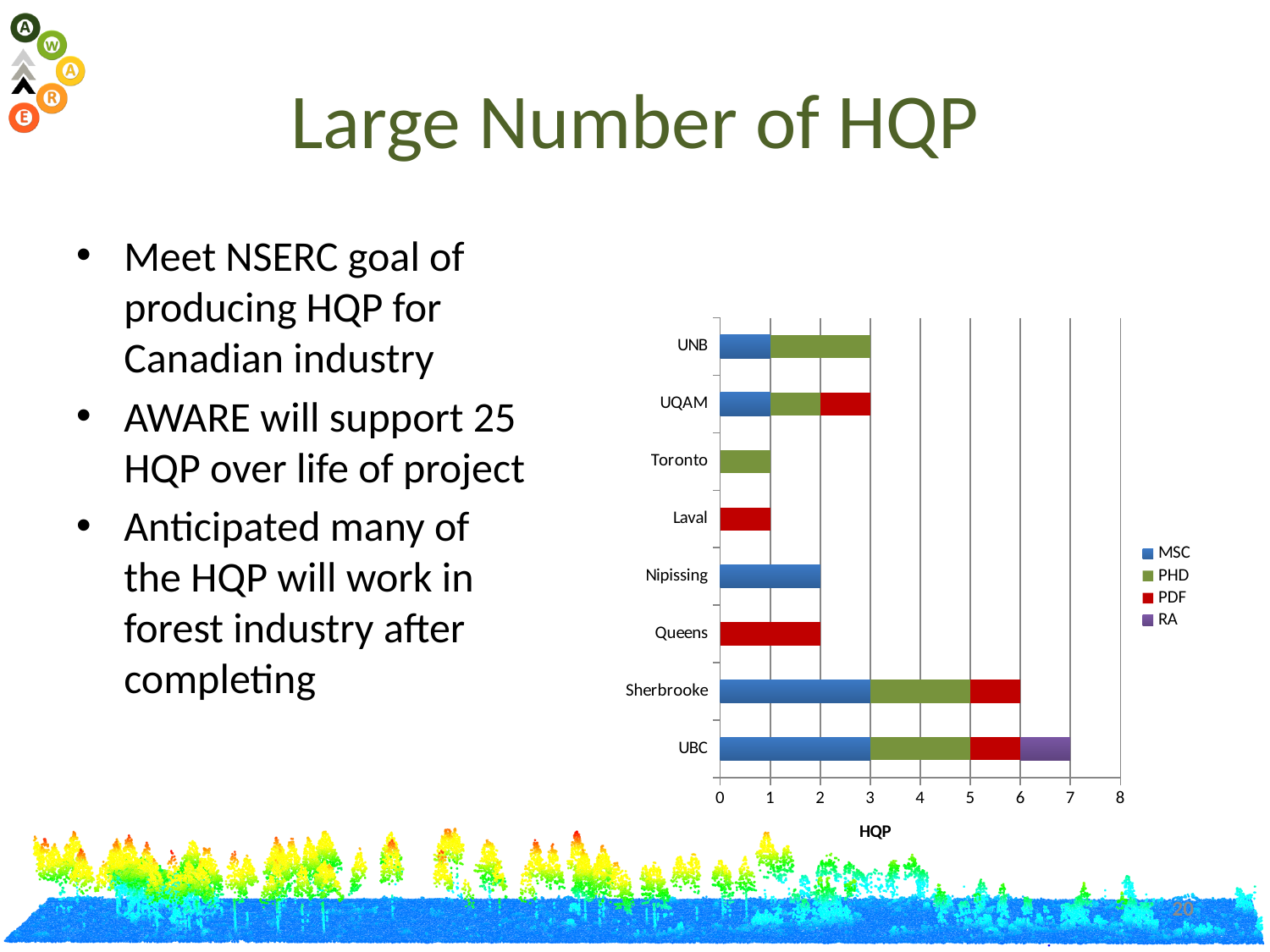
What is the MSC value for Nipissing? 2 Which institution has the largest total HQP bar? UBC What is the difference between the total HQP for UBC and for Sherbrooke? 1 How many institutions are shown on the chart's vertical axis? 8 What is the total HQP for UBC? 7 What is the total HQP for Sherbrooke? 6 What is the title of the horizontal axis of the chart? HQP What kind of chart is shown on the slide? bar chart How many series does the legend of the chart list? 4 Which legend series appears only in the UBC bar? RA Which has a larger total HQP bar, Sherbrooke or UNB? Sherbrooke Is the total value for Queens greater or less than 3? less